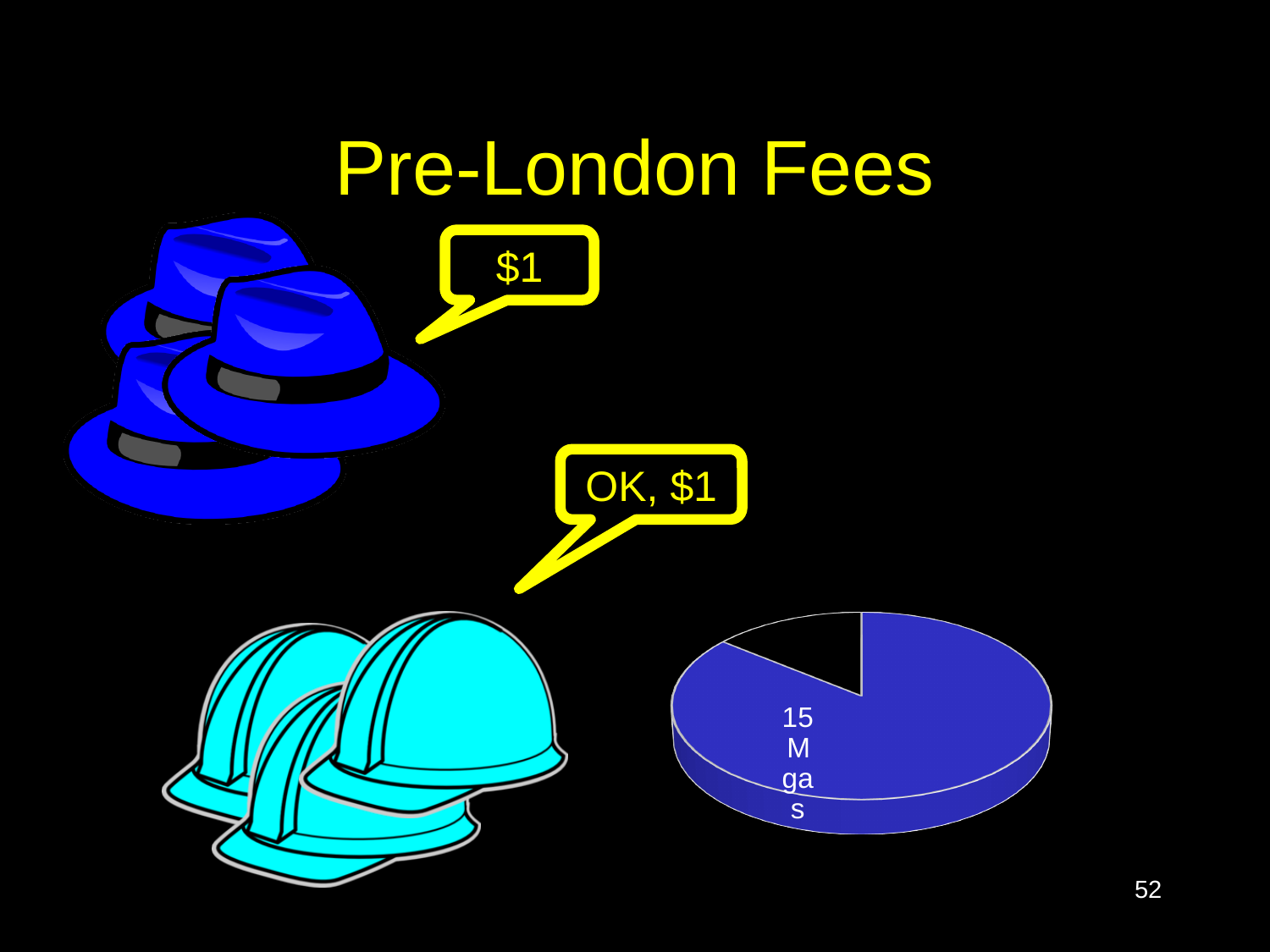
What colour is the slice labelled "15 M gas" in the pie chart? blue Which slice of the pie chart is larger, the blue slice labelled "15 M gas" or the unlabelled black slice? the blue slice labelled "15 M gas" Does the slice labelled "15 M gas" take up more or less than half of the pie chart? more than half What label is printed on the large blue slice of the pie chart? 15 M gas Is the pie chart drawn in 3D or flat 2D? 3D What kind of chart is shown on the slide? pie chart